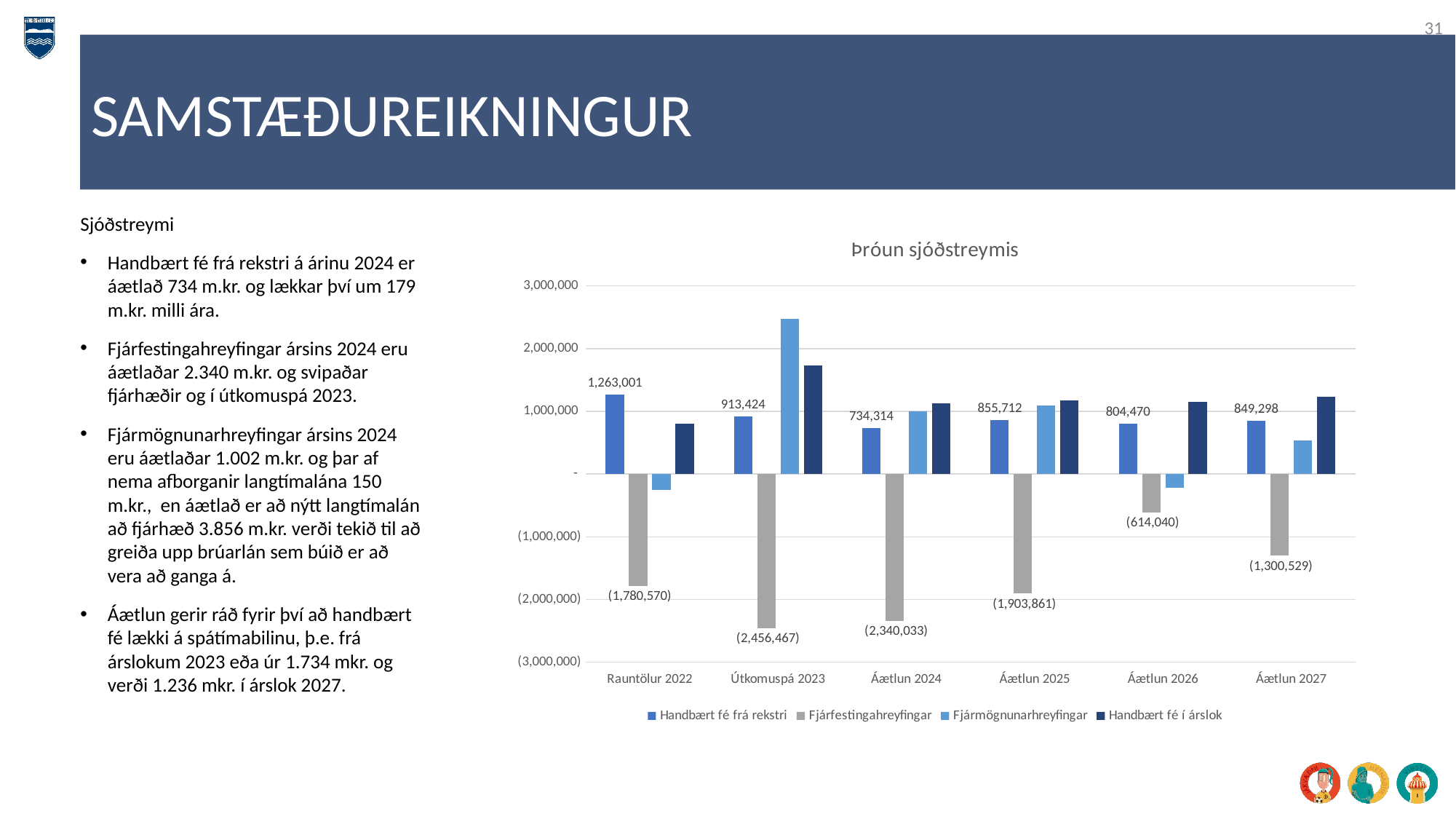
What type of chart is shown? bar chart Which category has the highest value for Handbært fé frá rekstri? Rauntölur 2022 What is the value of Fjárfestingahreyfingar for Útkomuspá 2023? (2,456,467) Which is larger, Handbært fé frá rekstri for Áætlun 2025 or for Áætlun 2026? Áætlun 2025 How many series does the legend list? 4 What is the value of Handbært fé frá rekstri for Rauntölur 2022? 1,263,001 What is the value of Fjárfestingahreyfingar for Áætlun 2026? (614,040) What is the difference between Handbært fé frá rekstri for Rauntölur 2022 and Útkomuspá 2023? 349,577 Is the value of Fjármögnunarhreyfingar for Útkomuspá 2023 greater or less than 2,000,000? greater What is the value of Handbært fé frá rekstri for Áætlun 2024? 734,314 How many categories are shown on the x axis? 6 Which category has the lowest value for Handbært fé frá rekstri? Áætlun 2024